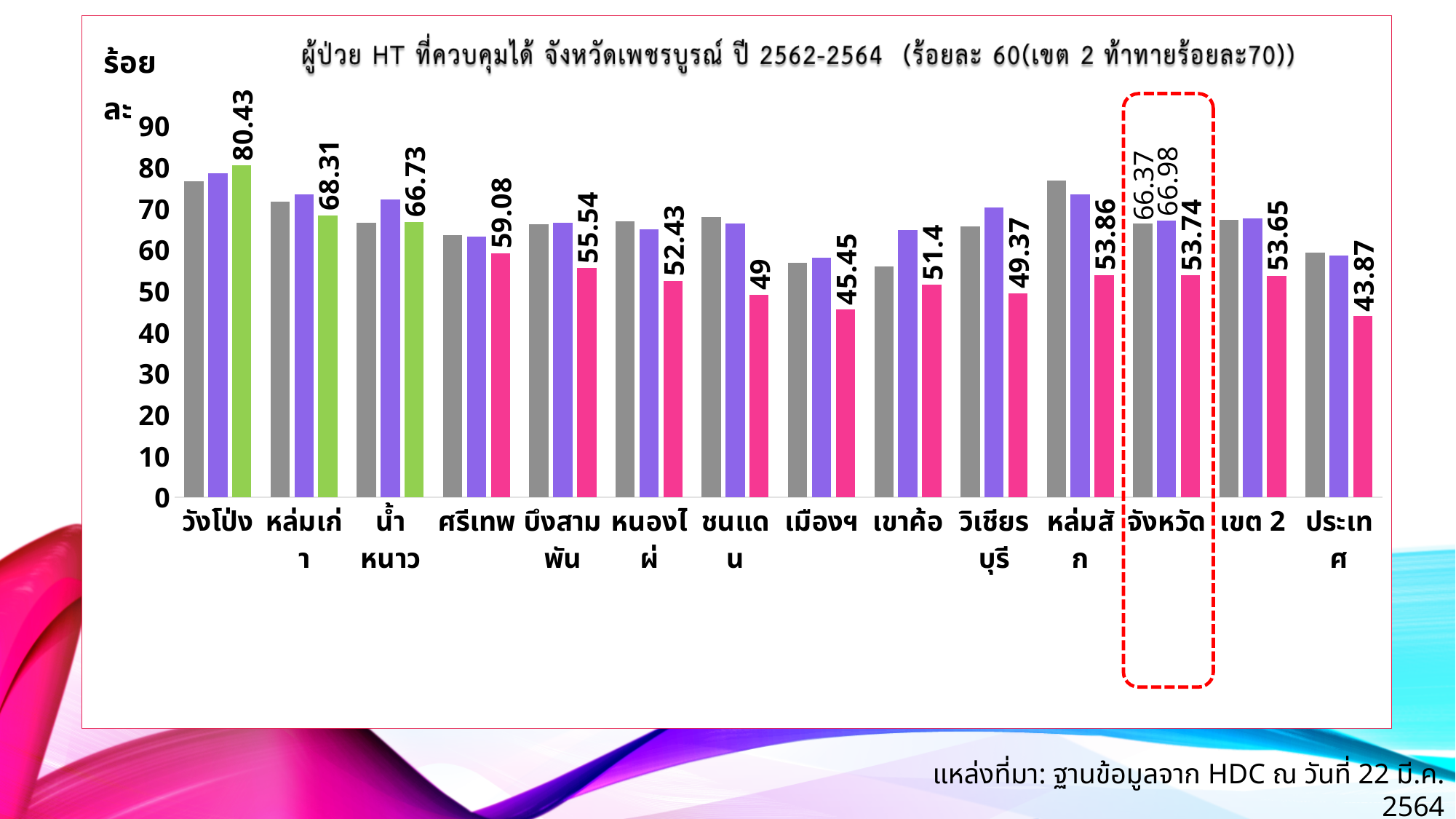
Is the value of the first (gray) bar for หล่มสัก greater or less than 70? greater Which has the larger labelled third-bar value, ศรีเทพ or บึงสามพัน? ศรีเทพ What is the labelled value of the third (pink) bar for ชนแดน? 49 What is the difference between the labelled third-bar values for วังโป่ง and ประเทศ? 36.56 What is the labelled value of the third (green) bar for วังโป่ง? 80.43 Among the labelled third bars, which category has the highest value? วังโป่ง For จังหวัด, what is the difference between the second bar (66.98) and the third bar (53.74)? 13.24 What is the labelled value of the third (pink) bar for ประเทศ? 43.87 Among the labelled third bars, which category has the lowest value? ประเทศ How many categories are shown on the x axis? 14 What is the labelled value of the first (gray) bar for จังหวัด? 66.37 What kind of chart is shown on the slide? bar chart